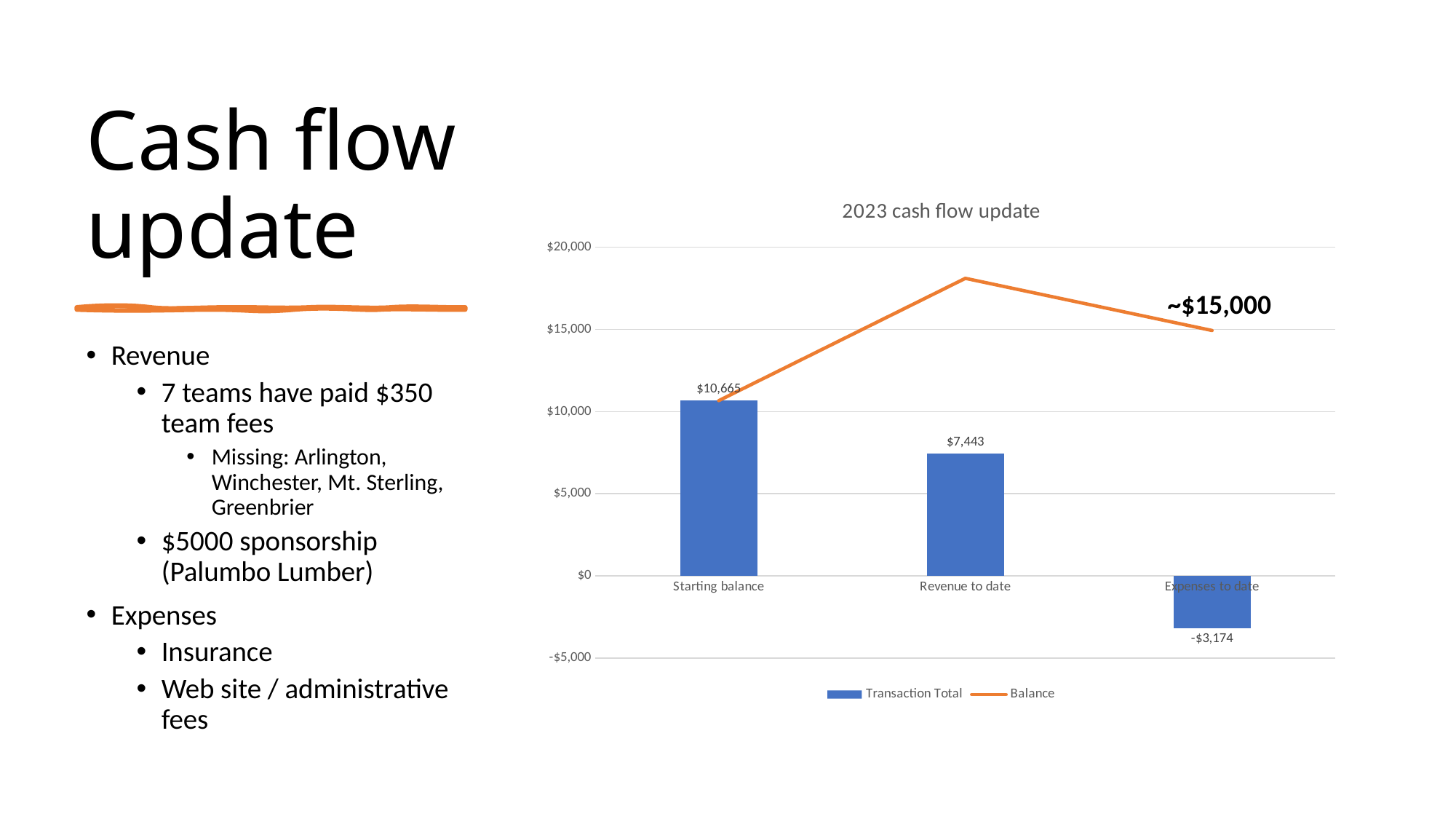
Is the Balance line value at Revenue to date greater or less than $15,000? greater How many series does the legend list? 2 What is the Transaction Total for Expenses to date? -$3,174 How many categories are shown on the x axis? 3 What kind of chart is shown on the slide? Combined bar and line chart Which category has the highest Transaction Total? Starting balance What is the Transaction Total for Revenue to date? $7,443 What is the Transaction Total for Starting balance? $10,665 Which category has the lowest Transaction Total? Expenses to date What is the difference between the Transaction Total for Starting balance and for Revenue to date? $3,222 What is the title of the chart? 2023 cash flow update Which is larger, the Transaction Total for Starting balance or for Revenue to date? Starting balance